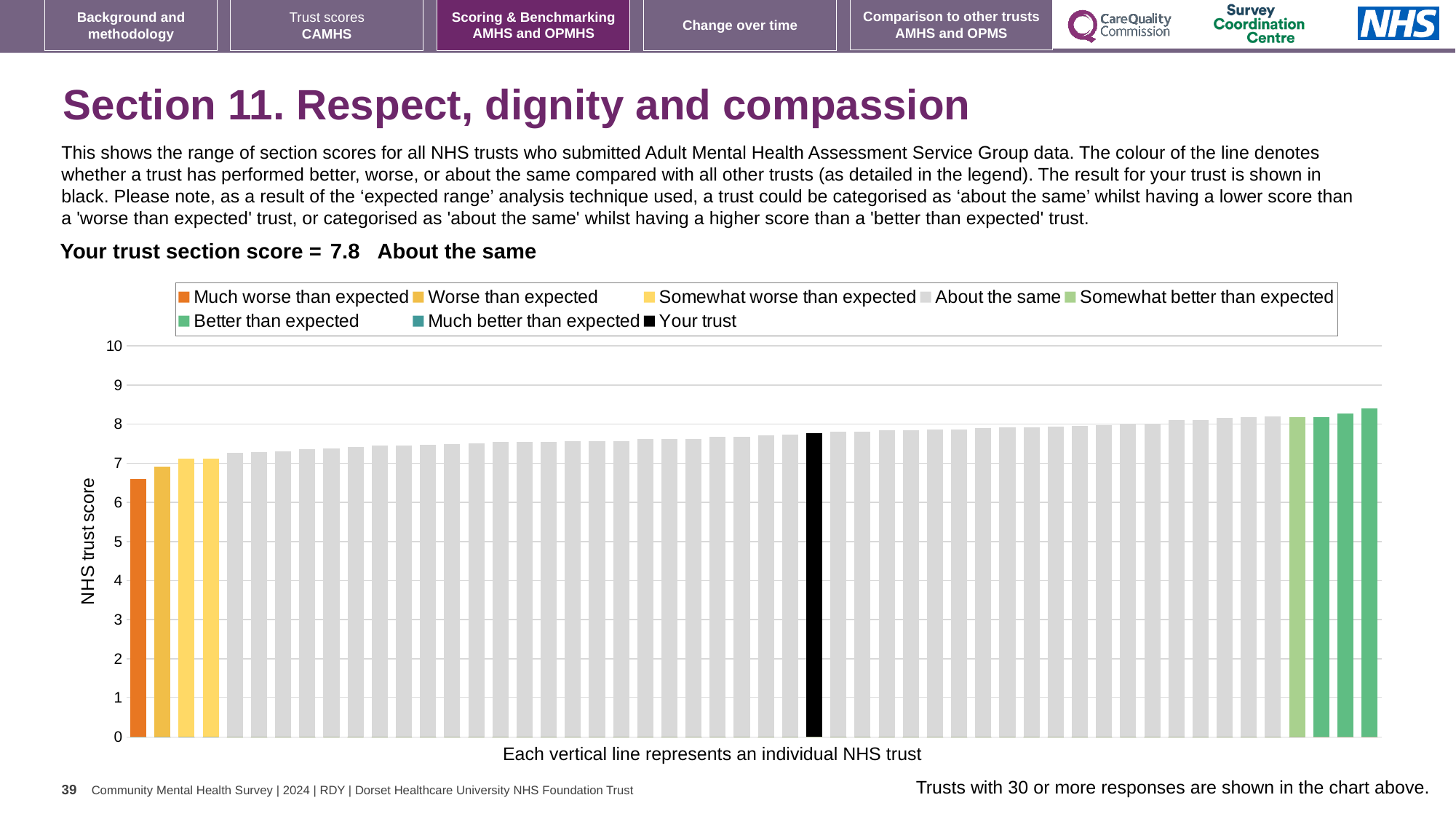
What kind of chart is shown on the slide? bar chart Do the bar values rise or fall from left to right along the x axis? rise Which legend category does the lowest bar in the chart belong to? Much worse than expected Is the value of the highest bar on the right greater or less than 8? greater Is the value of the black 'Your trust' bar greater or less than 7? greater How many entries does the chart legend list? 8 What is the section score for your trust shown on the slide? 7.8 Is the value of the lowest (orange) bar greater or less than 7? less How many orange 'Much worse than expected' bars are in the chart? 1 What colour is used for the 'Your trust' bar in the chart? black Which is larger, the black 'Your trust' bar or the orange bar at the far left? the black 'Your trust' bar What is the label on the y axis of the chart? NHS trust score